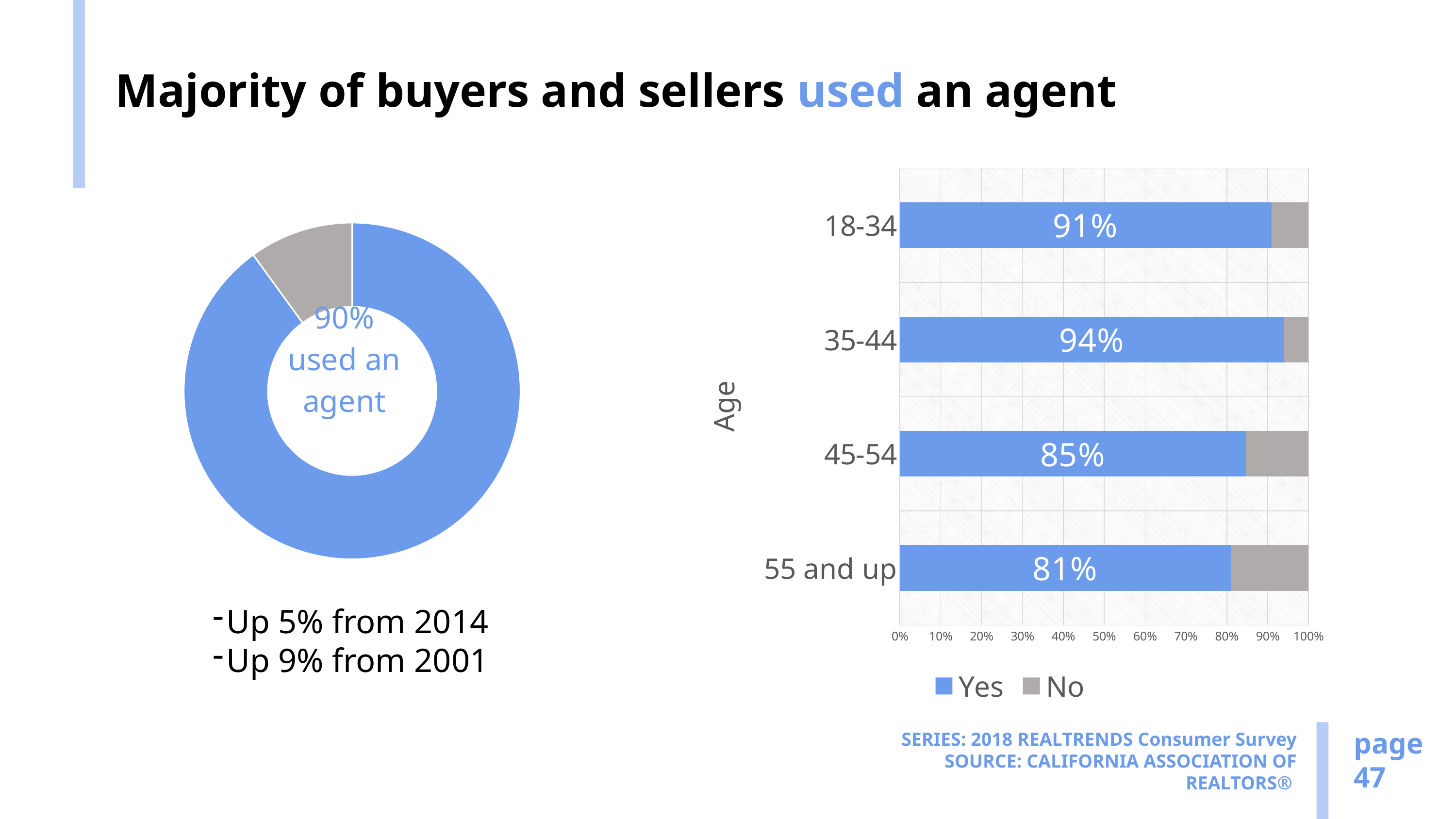
In the bar chart on the right, what is the difference between the Yes values for 18-34 and 45-54? 6% In the bar chart on the right, what is the Yes value for the 55 and up age group? 81% How many series does the legend of the bar chart on the right list? 2 In the doughnut chart on the left, what share of buyers and sellers used an agent? 90% In the bar chart on the right, what percentage of the 35-44 age group used an agent (Yes)? 94% In the bar chart on the right, which age group has the highest Yes percentage? 35-44 How many age groups are shown in the bar chart on the right? 4 In the bar chart on the right, is the Yes value for 55 and up greater or less than 90%? less What kind of chart is on the left side of the slide? Doughnut chart In the bar chart on the right, which has a larger Yes value: 18-34 or 45-54? 18-34 In the bar chart on the right, what colour represents the No series? Gray In the bar chart on the right, which age group has the lowest Yes percentage? 55 and up